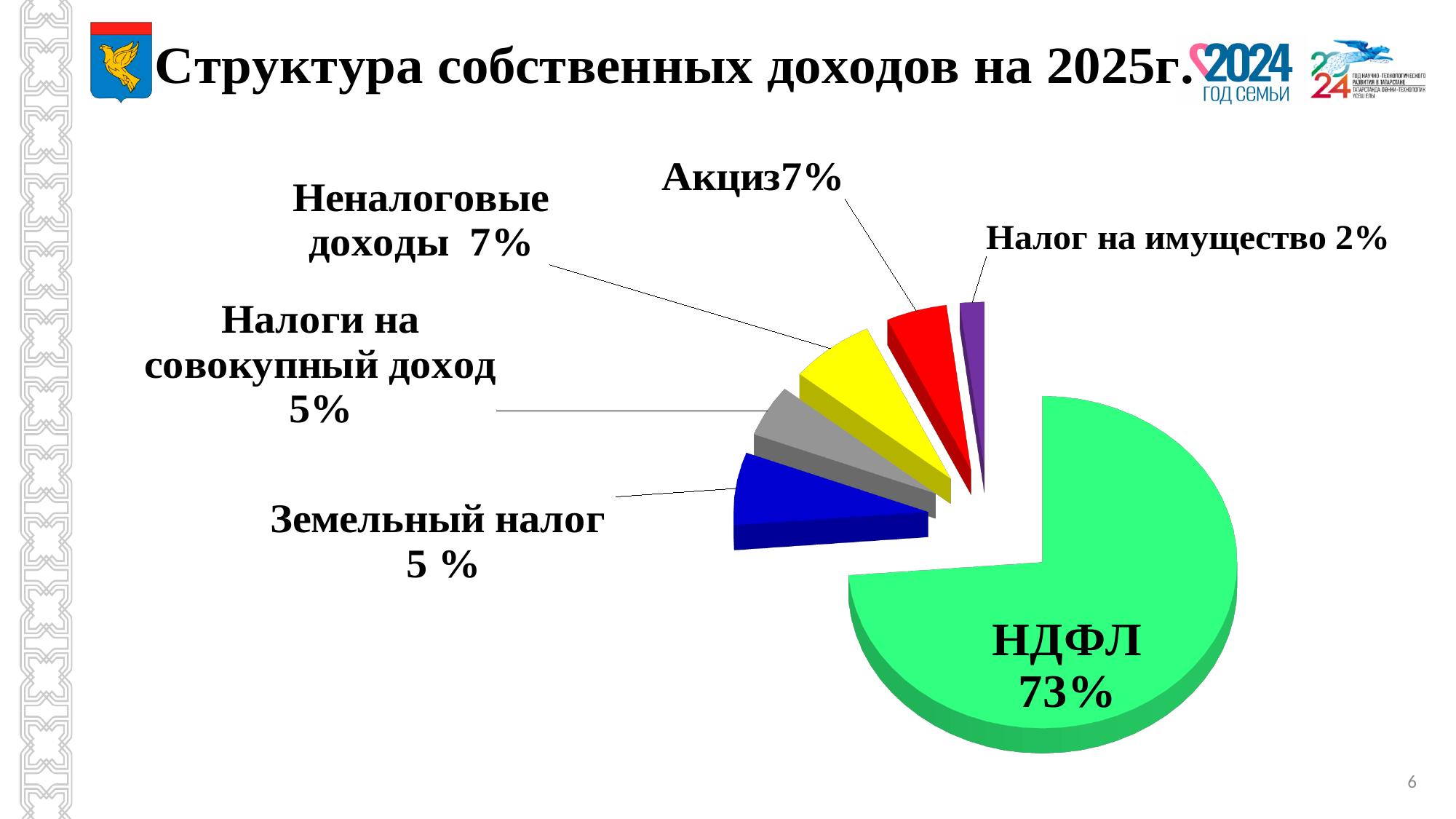
Which category has the smallest slice of the pie chart? Налог на имущество What share is shown for Неналоговые доходы? 7% What type of chart is shown on the slide? Pie chart Which category has the largest slice of the pie chart? НДФЛ What percentage is shown for Акциз? 7% What is the share shown for Налог на имущество? 2% What share of own revenues does НДФЛ account for in the pie chart? 73% Which is larger: the share of Акциз or the share of Земельный налог? Акциз By how many percentage points does the НДФЛ share exceed the Акциз share? 66% What is the difference between the shares of Неналоговые доходы and Налог на имущество? 5% What share is shown for Земельный налог? 5 % How many slices does the pie chart have? 6